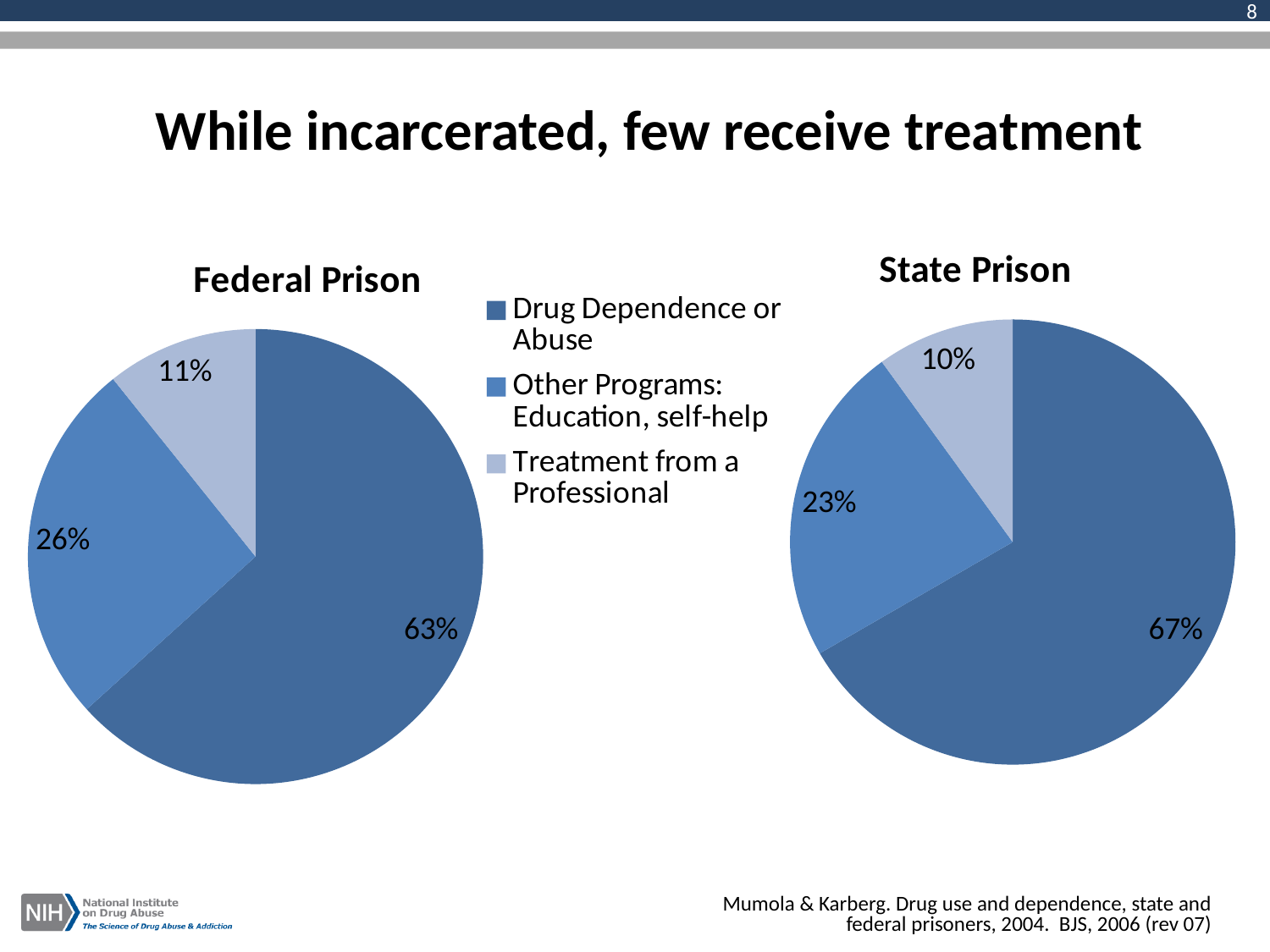
How many entries does the legend list? 3 In the Federal Prison pie chart, what percentage is shown for Drug Dependence or Abuse? 63% In the Federal Prison pie chart, which category has the smallest slice? Treatment from a Professional Which is larger: the Other Programs: Education, self-help share in the Federal Prison chart or in the State Prison chart? Federal Prison What type of chart is the State Prison chart? Pie chart In the State Prison pie chart, which category has the largest slice? Drug Dependence or Abuse What is the difference between the Drug Dependence or Abuse share in the State Prison chart and in the Federal Prison chart? 4 percentage points What is the title of the chart on the left side of the slide? Federal Prison In the Federal Prison pie chart, what percentage is shown for Other Programs: Education, self-help? 26% In the State Prison pie chart, what percentage is shown for Other Programs: Education, self-help? 23% How many slices does the Federal Prison pie chart have? 3 In the State Prison pie chart, what percentage is shown for Treatment from a Professional? 10%